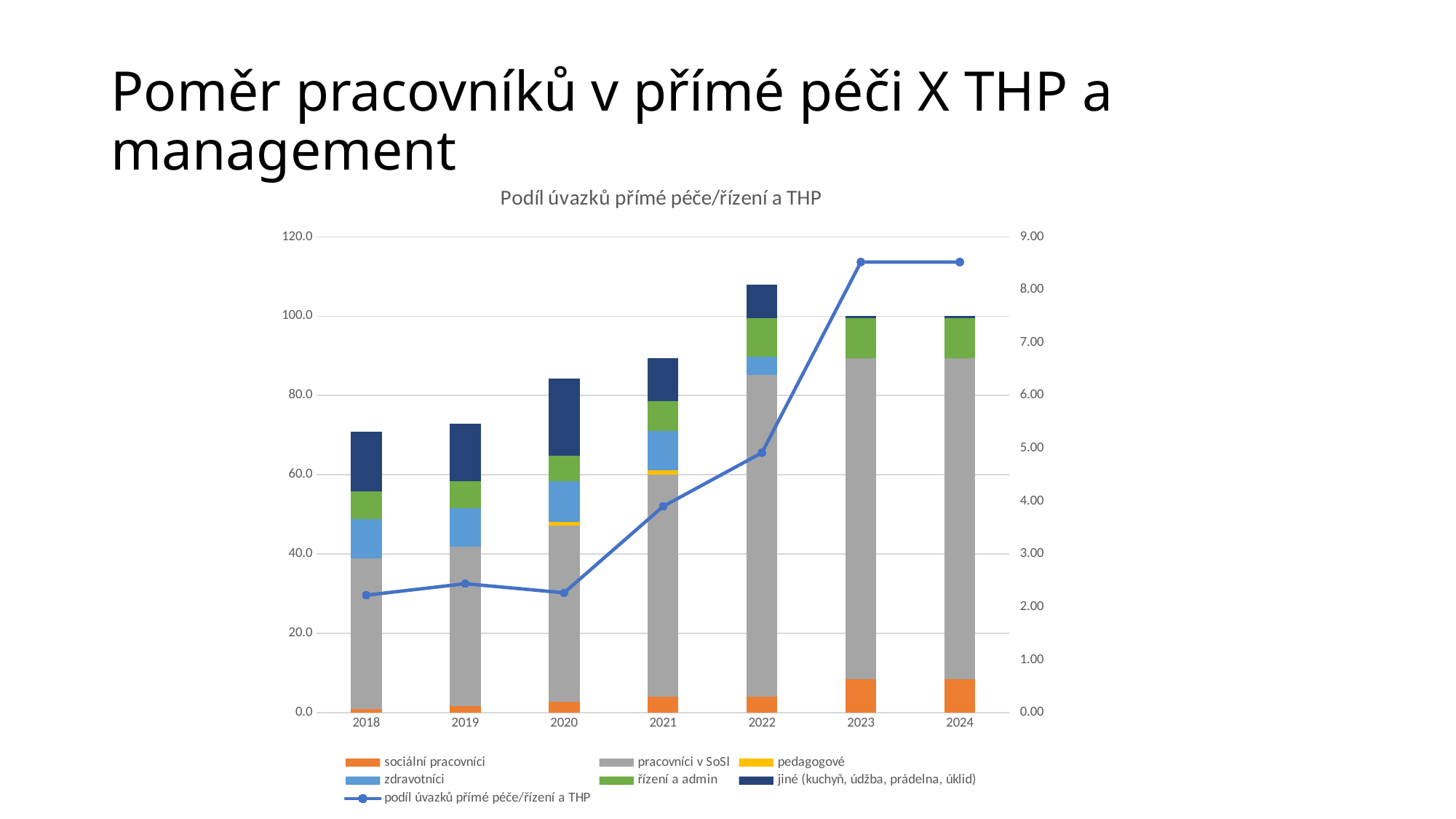
Which year has the tallest stacked bar? 2022 Is the total of the stacked bar for 2022 greater or less than 100.0? greater How many years are shown on the x axis of the chart? 7 Is the total of the stacked bar for 2018 greater or less than 80.0? less Does the line 'podíl úvazků přímé péče/řízení a THP' generally rise or fall from 2018 to 2024? rise Is the value of the line 'podíl úvazků přímé péče/řízení a THP' for 2018 greater or less than 3.00? less What kind of chart is shown on the slide? Stacked bar chart with a line How many series does the chart legend list? 7 Which legend entry is shown in orange? sociální pracovníci What is the title of the chart? Podíl úvazků přímé péče/řízení a THP Which stacked bar is taller, 2018 or 2022? 2022